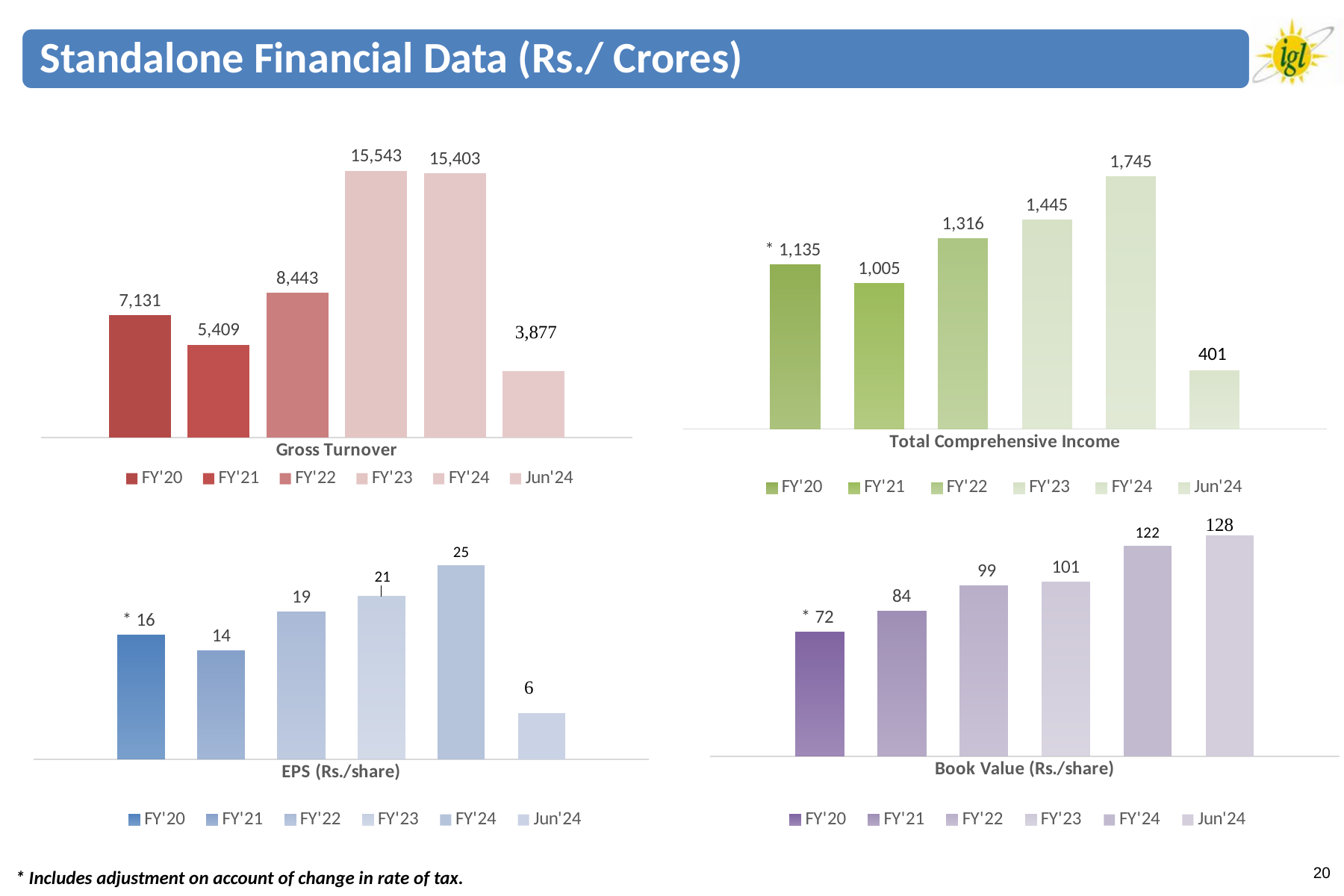
In the Gross Turnover chart, what is the value for FY'23? 15,543 In the Book Value (Rs./share) chart, what is the value for FY'22? 99 In the EPS (Rs./share) chart, what is the value for FY'24? 25 In the Gross Turnover chart, what is the difference between FY'22 and FY'21? 3,034 In the Total Comprehensive Income chart, what is the value for FY'24? 1,745 What kind of chart is the EPS (Rs./share) chart? bar chart How many bars are plotted in the Book Value (Rs./share) chart? 6 In the EPS (Rs./share) chart, what is the difference between FY'24 and Jun'24? 19 In the Total Comprehensive Income chart, which is larger, FY'20 or FY'21? FY'20 In the Book Value (Rs./share) chart, do the values rise or fall from FY'20 to Jun'24? rise In the Total Comprehensive Income chart, which period has the highest value? FY'24 In the Gross Turnover chart, which period has the lowest value? Jun'24